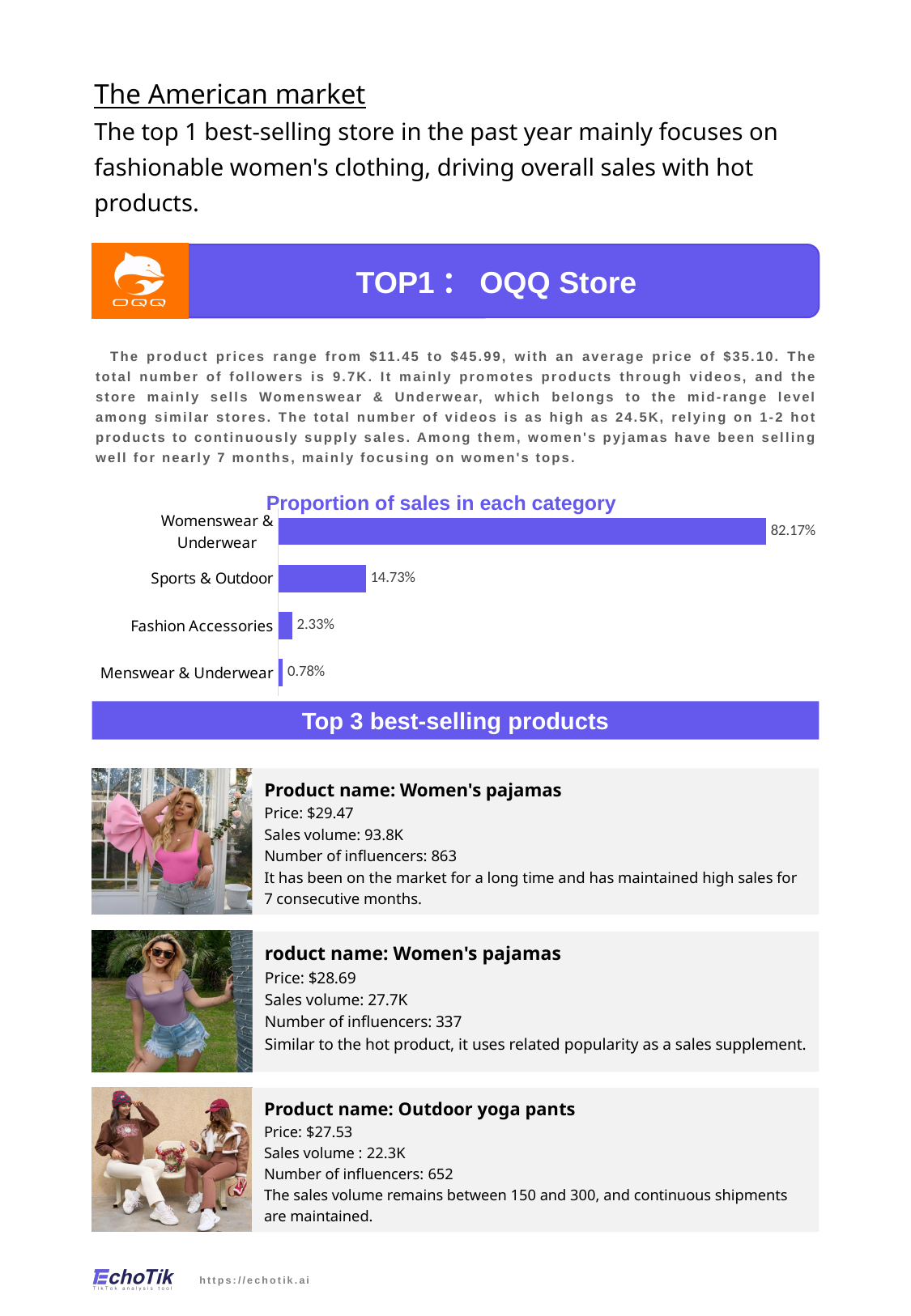
What is the proportion of sales for Fashion Accessories? 2.33% Which category has the lowest proportion of sales? Menswear & Underwear What is the difference in sales proportion between Fashion Accessories and Menswear & Underwear? 1.55% What is the title of the chart? Proportion of sales in each category What type of chart is used to show the proportion of sales in each category? Bar chart Which category has the highest proportion of sales? Womenswear & Underwear What is the proportion of sales for Menswear & Underwear? 0.78% How many categories are shown in the chart? 4 What is the proportion of sales for Sports & Outdoor? 14.73% What is the proportion of sales for Womenswear & Underwear? 82.17% What is the difference in sales proportion between Womenswear & Underwear and Sports & Outdoor? 67.44% Which has a larger proportion of sales, Sports & Outdoor or Fashion Accessories? Sports & Outdoor